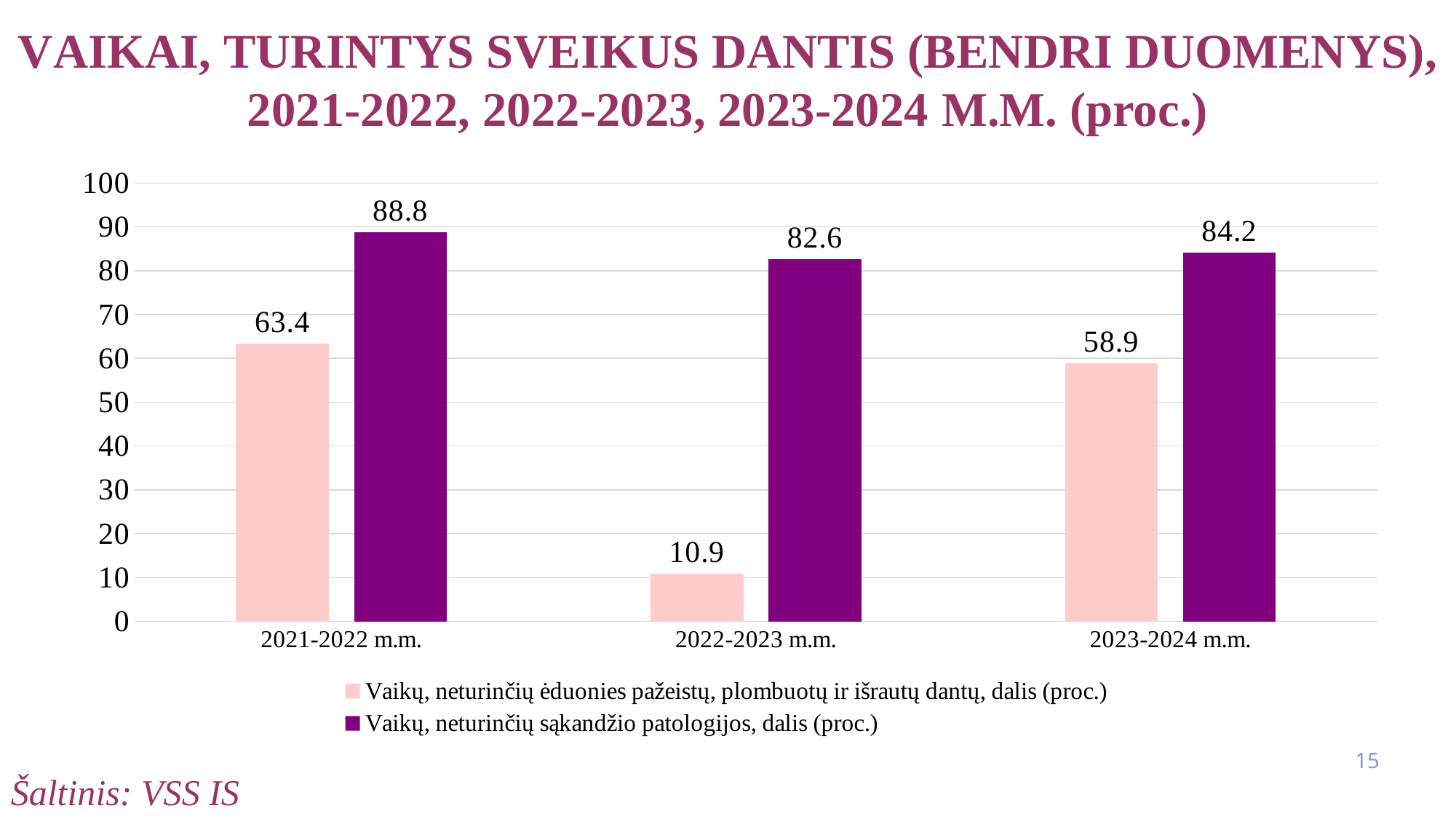
How many series does the legend list? 2 What colour are the bars for 'Vaikų, neturinčių sąkandžio patologijos, dalis (proc.)'? Purple Which is larger: the 'Vaikų, neturinčių ėduonies pažeistų, plombuotų ir išrautų dantų, dalis (proc.)' value in 2021-2022 m.m. or in 2023-2024 m.m.? 2021-2022 m.m. What is the difference between the two series' values in 2022-2023 m.m.? 71.7 What kind of chart is shown on the slide? Bar chart What is the difference between the 'Vaikų, neturinčių sąkandžio patologijos, dalis (proc.)' values in 2021-2022 m.m. and 2023-2024 m.m.? 4.6 In which school year is the value for 'Vaikų, neturinčių ėduonies pažeistų, plombuotų ir išrautų dantų, dalis (proc.)' lowest? 2022-2023 m.m. What is the value for 'Vaikų, neturinčių sąkandžio patologijos, dalis (proc.)' in 2022-2023 m.m.? 82.6 How many school years are shown on the x axis? 3 What is the value for 'Vaikų, neturinčių ėduonies pažeistų, plombuotų ir išrautų dantų, dalis (proc.)' in 2021-2022 m.m.? 63.4 What is the value for 'Vaikų, neturinčių ėduonies pažeistų, plombuotų ir išrautų dantų, dalis (proc.)' in 2023-2024 m.m.? 58.9 In which school year is the value for 'Vaikų, neturinčių sąkandžio patologijos, dalis (proc.)' highest? 2021-2022 m.m.